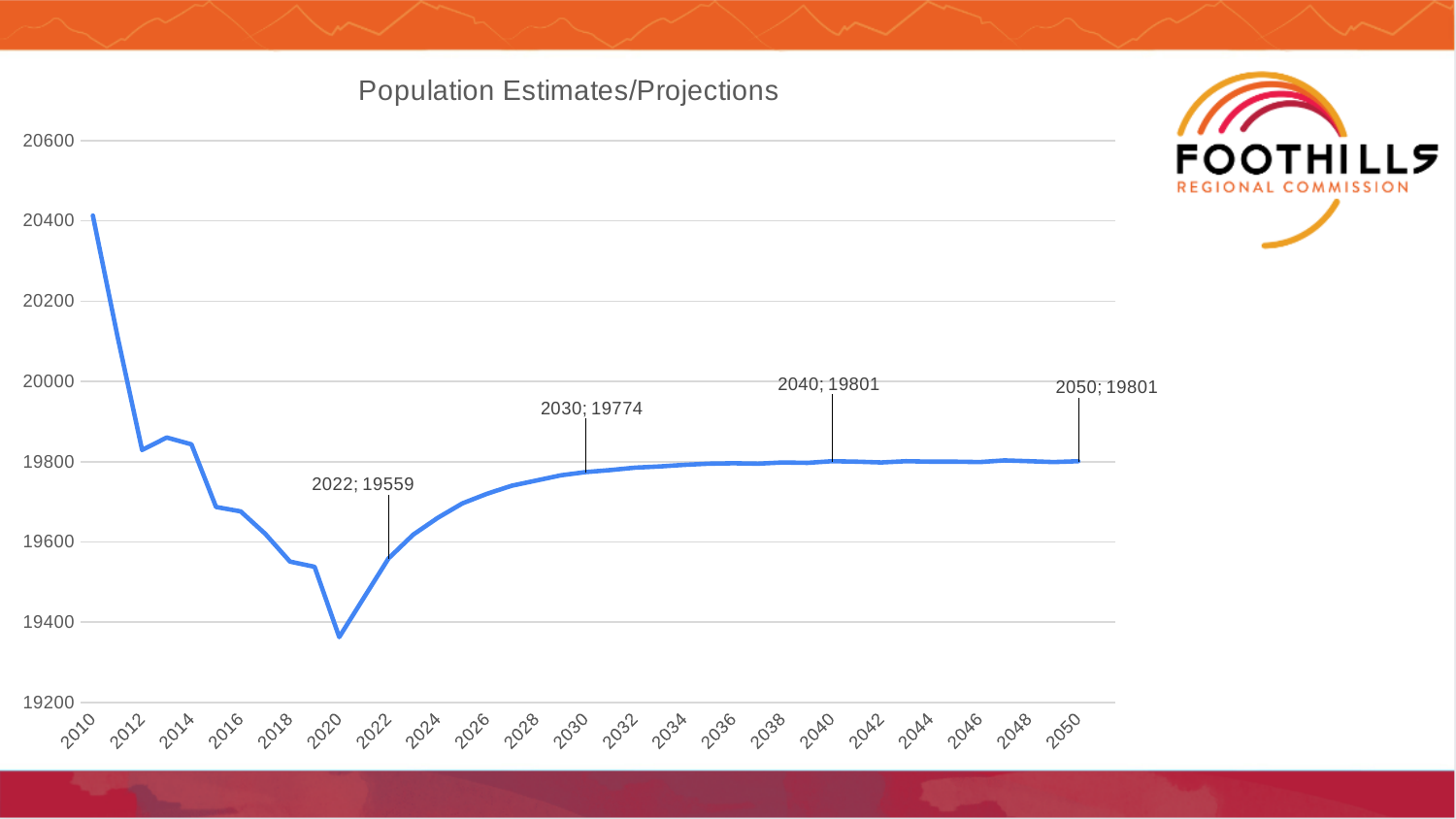
Is the value for 2020 greater or less than 19400? less What is the difference between the labelled values for 2030 and 2022? 215 What is the population value labelled for 2040? 19801 In which year does the line reach its highest point? 2010 In which year does the line reach its lowest point? 2020 What kind of chart is shown on the slide? line chart Is the value for 2010 greater or less than 20200? greater What is the difference between the labelled values for 2040 and 2030? 27 What is the population value labelled for 2030? 19774 Which year has the larger labelled value, 2022 or 2030? 2030 What is the population value labelled for 2022? 19559 What is the population value labelled for 2050? 19801